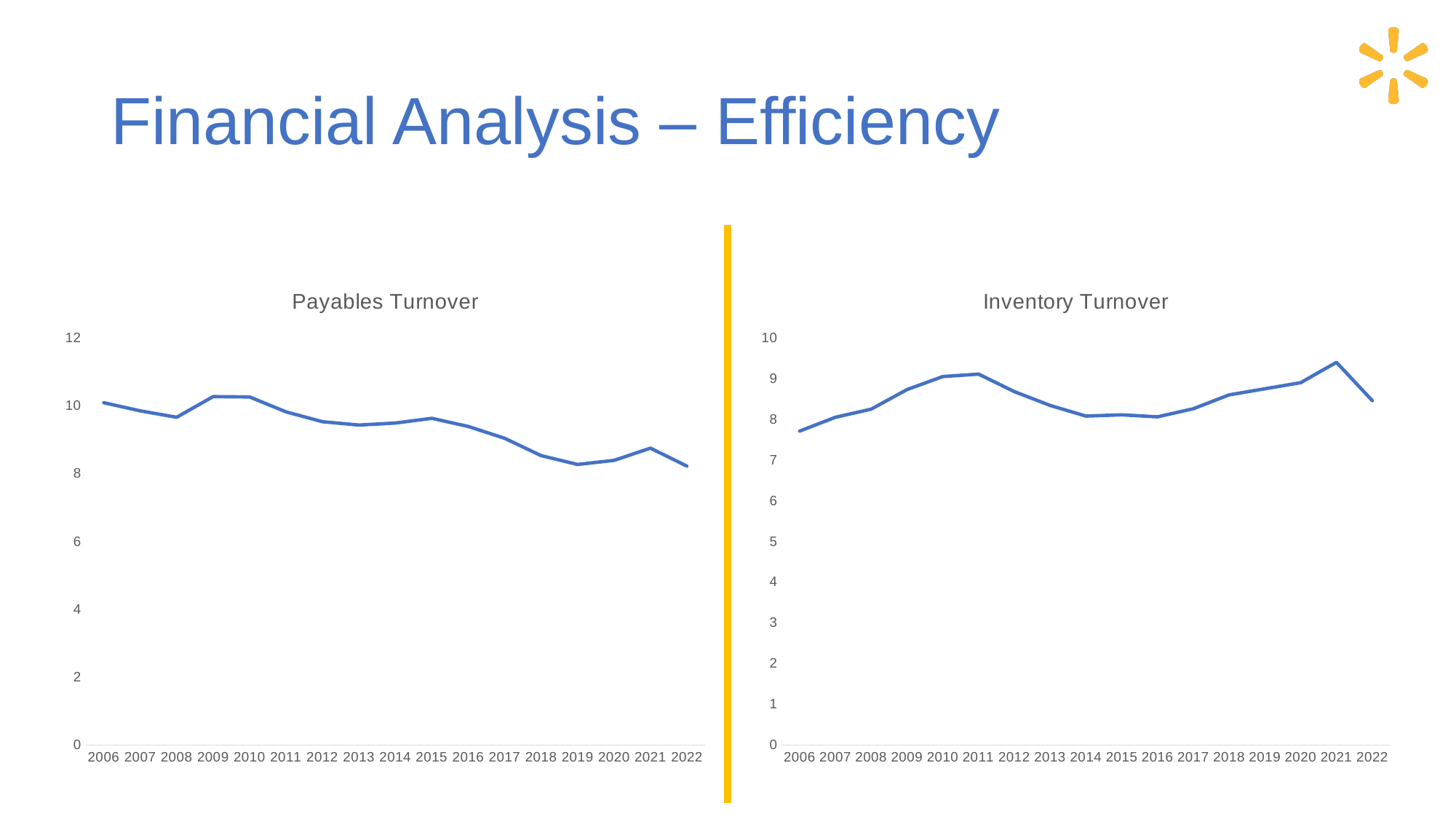
On the Payables Turnover chart, do the values overall rise or fall from 2006 to 2022? fall On the Payables Turnover chart, which year has the larger value, 2009 or 2019? 2009 On the Inventory Turnover chart, is the value for 2021 greater or less than 9? greater On the Inventory Turnover chart, is the value for 2006 greater or less than 8? less On the Payables Turnover chart, is the value for 2019 greater or less than 10? less On the Inventory Turnover chart, do the values overall rise or fall from 2006 to 2022? rise On the Inventory Turnover chart, which year has the lowest value? 2006 How many years are plotted on the Inventory Turnover chart? 17 On the Inventory Turnover chart, which year has the highest value? 2021 What is the title of the chart on the right side of the slide? Inventory Turnover What kind of chart is the Payables Turnover chart? line chart On the Inventory Turnover chart, which year has the larger value, 2016 or 2021? 2021